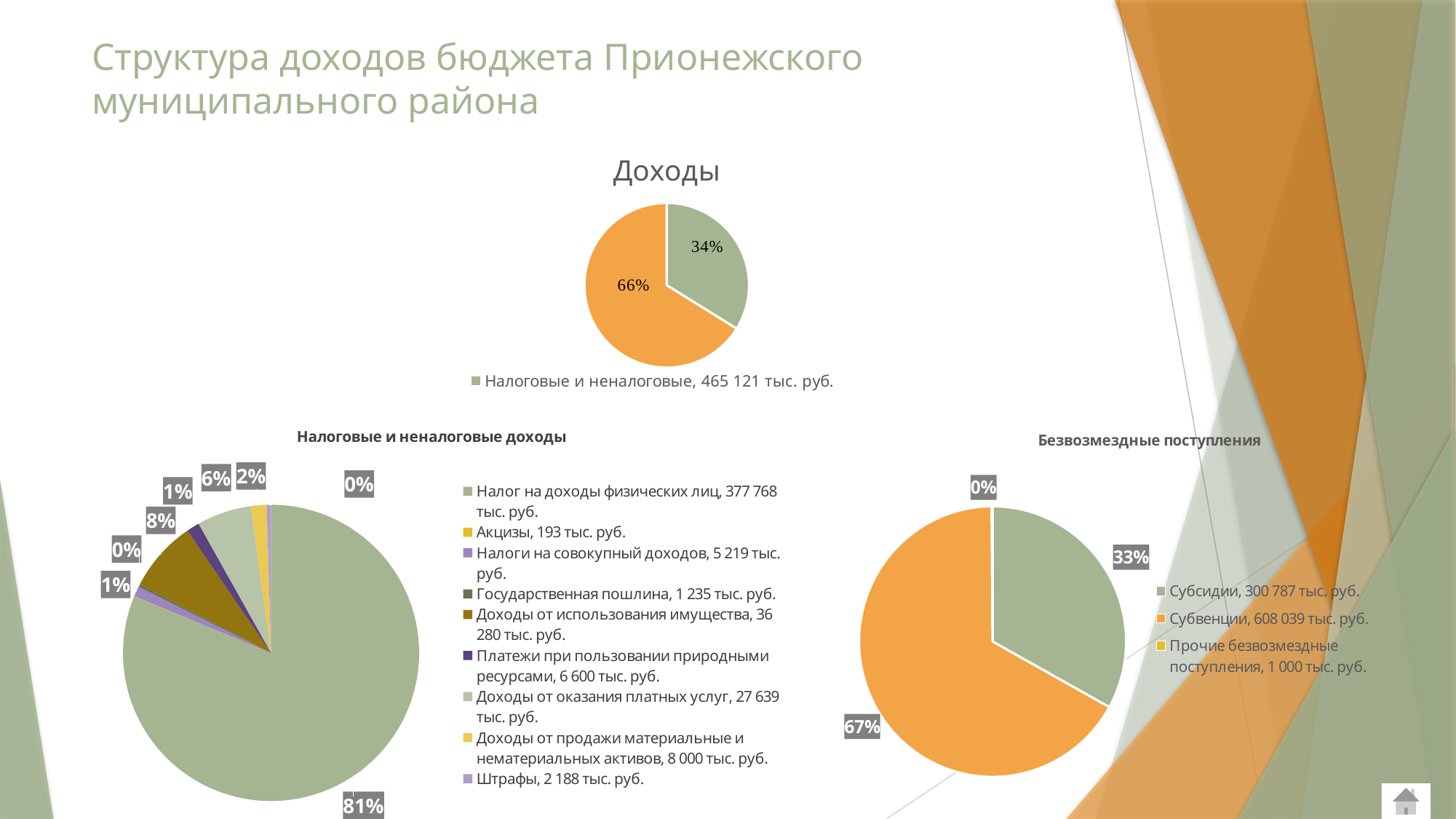
In the "Безвозмездные поступления" chart, which category has the smallest value? Прочие безвозмездные поступления In the "Доходы" pie chart, what share is labelled on the orange slice? 66% In the "Налоговые и неналоговые доходы" chart, what value does the legend give for "Акцизы"? 193 тыс. руб. In the "Безвозмездные поступления" chart, what value does the legend give for "Субвенции"? 608 039 тыс. руб. In the "Безвозмездные поступления" chart, what share is labelled on the "Субсидии" slice? 33% What kind of chart is the "Доходы" chart at the top of the slide? pie chart In the "Налоговые и неналоговые доходы" chart, which is larger: "Доходы от использования имущества" or "Доходы от оказания платных услуг"? Доходы от использования имущества In the "Доходы" chart, what value does the legend give for "Налоговые и неналоговые"? 465 121 тыс. руб. In the "Налоговые и неналоговые доходы" chart, what value does the legend give for "Налог на доходы физических лиц"? 377 768 тыс. руб. In the "Доходы" pie chart, what share is labelled on the green slice? 34% How many entries does the legend of the "Налоговые и неналоговые доходы" chart list? 9 In the "Налоговые и неналоговые доходы" chart, what is the largest share labelled on the pie? 81%